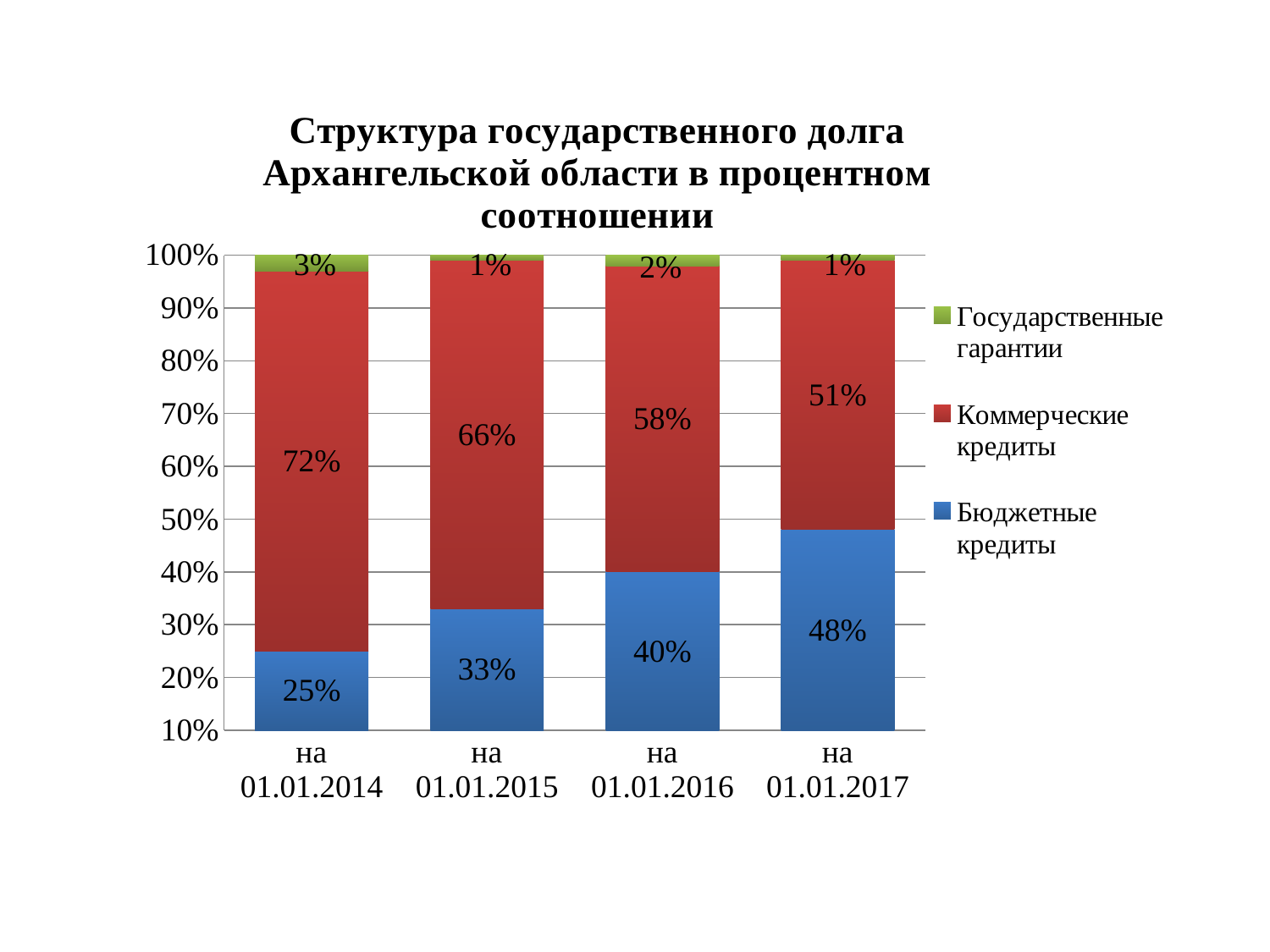
What kind of chart is this? Stacked bar chart Which is larger: Коммерческие кредиты на 01.01.2015 or Бюджетные кредиты на 01.01.2015? Коммерческие кредиты Does the share of Бюджетные кредиты rise or fall from 01.01.2014 to 01.01.2017? Rise How many periods are shown on the x axis? 4 What is the value for Коммерческие кредиты на 01.01.2017? 51% What is the value for Государственные гарантии на 01.01.2014? 3% In which period is Бюджетные кредиты highest? на 01.01.2017 In which period is Коммерческие кредиты lowest? на 01.01.2017 What is the value for Бюджетные кредиты на 01.01.2014? 25% What is the difference between Бюджетные кредиты на 01.01.2017 and на 01.01.2014? 23% How many series does the legend list? 3 What is the value for Коммерческие кредиты на 01.01.2016? 58%